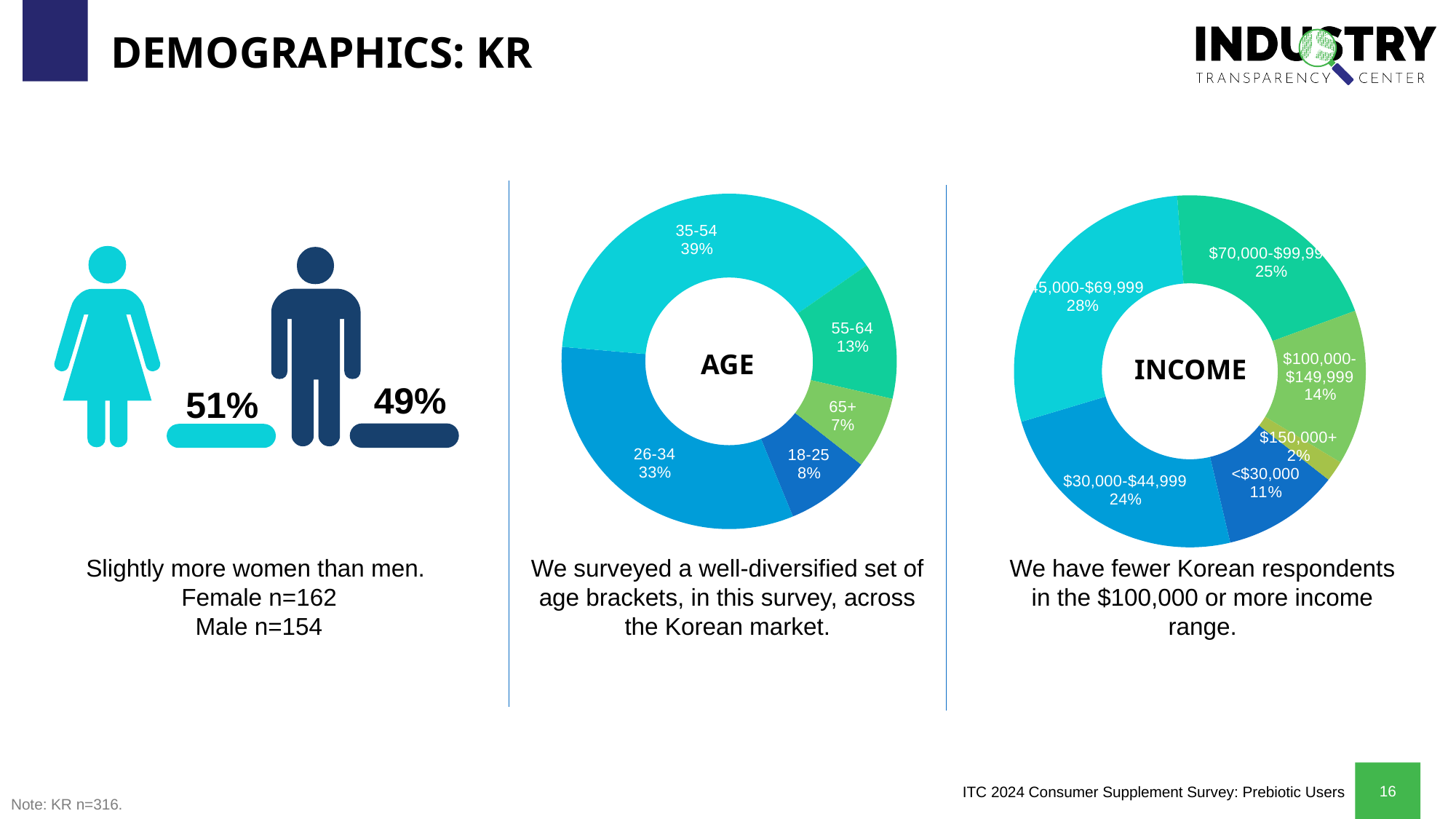
In the INCOME chart, what is the combined share of respondents earning $100,000 or more? 16% What kind of chart is the AGE chart? Donut (pie) chart In the AGE chart, which age bracket has the largest share? 35-54 What percentage of respondents are female according to the gender graphic? 51% In the INCOME chart, which income bracket has the smallest share? $150,000+ In the AGE chart, how many age brackets are shown? 5 In the AGE chart, what share of respondents are aged 35-54? 39% In the AGE chart, which age bracket has the smallest share? 65+ In the AGE chart, what is the difference in percentage points between the 26-34 and 18-25 brackets? 25 In the INCOME chart, what share of respondents earn $45,000-$69,999? 28% In the INCOME chart, how many income brackets are shown? 6